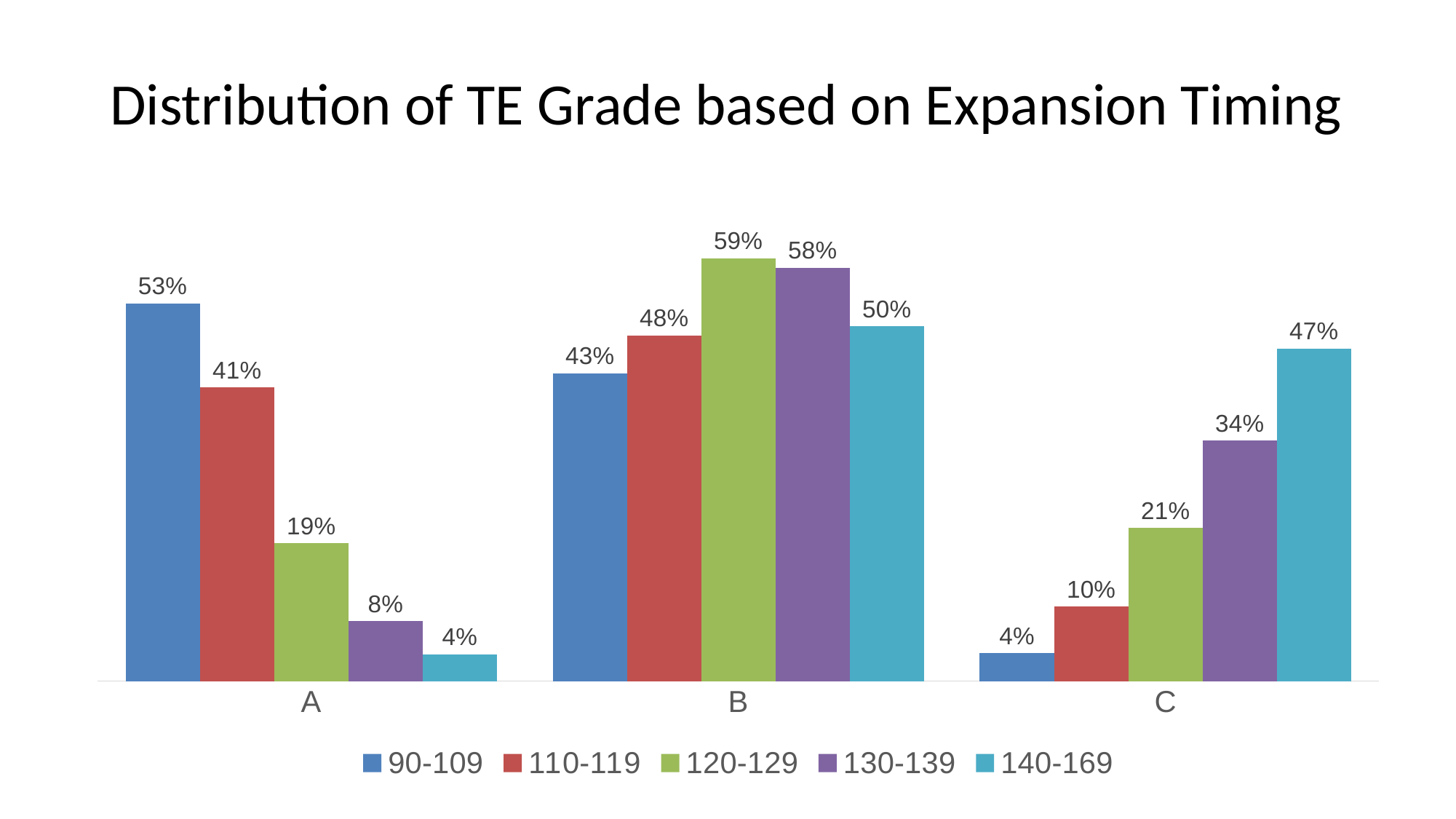
What is the difference between the 90-109 value and the 140-169 value in category A? 49% What kind of chart is shown on the slide? Bar chart Which series has the highest value in category B? 120-129 How many series does the legend list? 5 Which is larger in category C: the 130-139 value or the 120-129 value? 130-139 What is the value for the 90-109 series in category A? 53% What is the title of the chart? Distribution of TE Grade based on Expansion Timing How many categories are shown on the x axis? 3 What is the value for the 140-169 series in category C? 47% What is the value for the 120-129 series in category B? 59% Which series has the lowest value in category A? 140-169 Do the values for the 140-169 series rise or fall from category A to category C? Rise